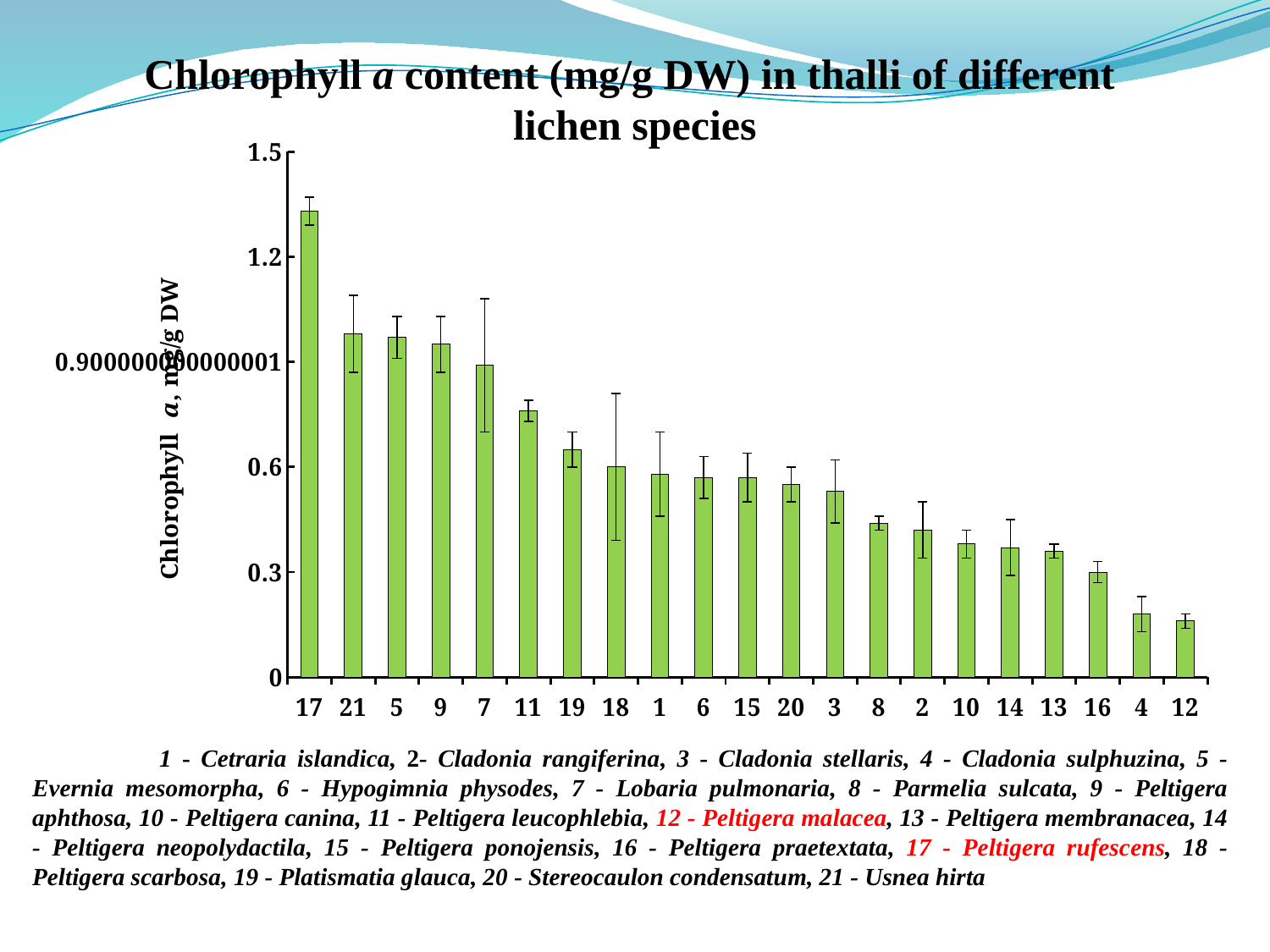
Which species number has the lowest chlorophyll a content? 12 Is the value for species 11 greater or less than 0.9? less Is the value for species 2 greater or less than 0.3? greater What kind of chart is shown on the slide? bar chart How many lichen species (bars) are plotted in the chart? 21 Which has a higher chlorophyll a content, species 11 or species 19? 11 Which species number has the highest chlorophyll a content? 17 Is the value for species 17 greater or less than 1.2? greater Do the bar values rise or fall from left to right along the x axis? fall What is the label of the y axis? Chlorophyll a, mg/g DW